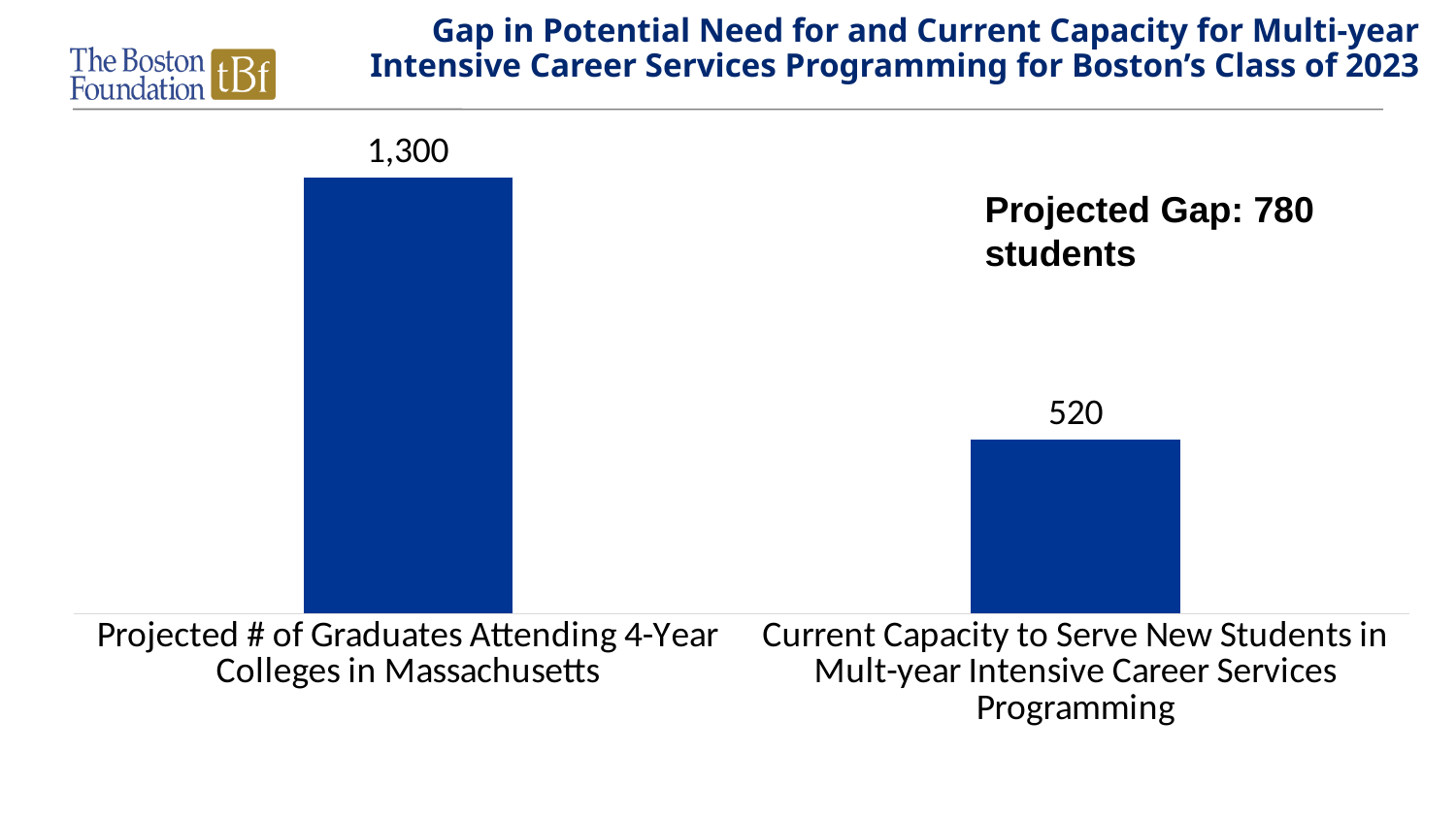
Which category has the lowest value? Current Capacity to Serve New Students in Mult-year Intensive Career Services Programming Which category has the highest value? Projected # of Graduates Attending 4-Year Colleges in Massachusetts What is the value for Current Capacity to Serve New Students in Mult-year Intensive Career Services Programming? 520 What is the title of the chart? Gap in Potential Need for and Current Capacity for Multi-year Intensive Career Services Programming for Boston's Class of 2023 What is the projected gap in students stated on the slide? 780 students Which is larger: the projected number of graduates attending 4-year colleges in Massachusetts or the current capacity to serve new students? Projected # of Graduates Attending 4-Year Colleges in Massachusetts What is the difference between the projected number of graduates attending 4-year colleges in Massachusetts and the current capacity to serve new students? 780 How many categories are shown in the chart? 2 What kind of chart is shown on the slide? Bar chart What is the value for Projected # of Graduates Attending 4-Year Colleges in Massachusetts? 1,300